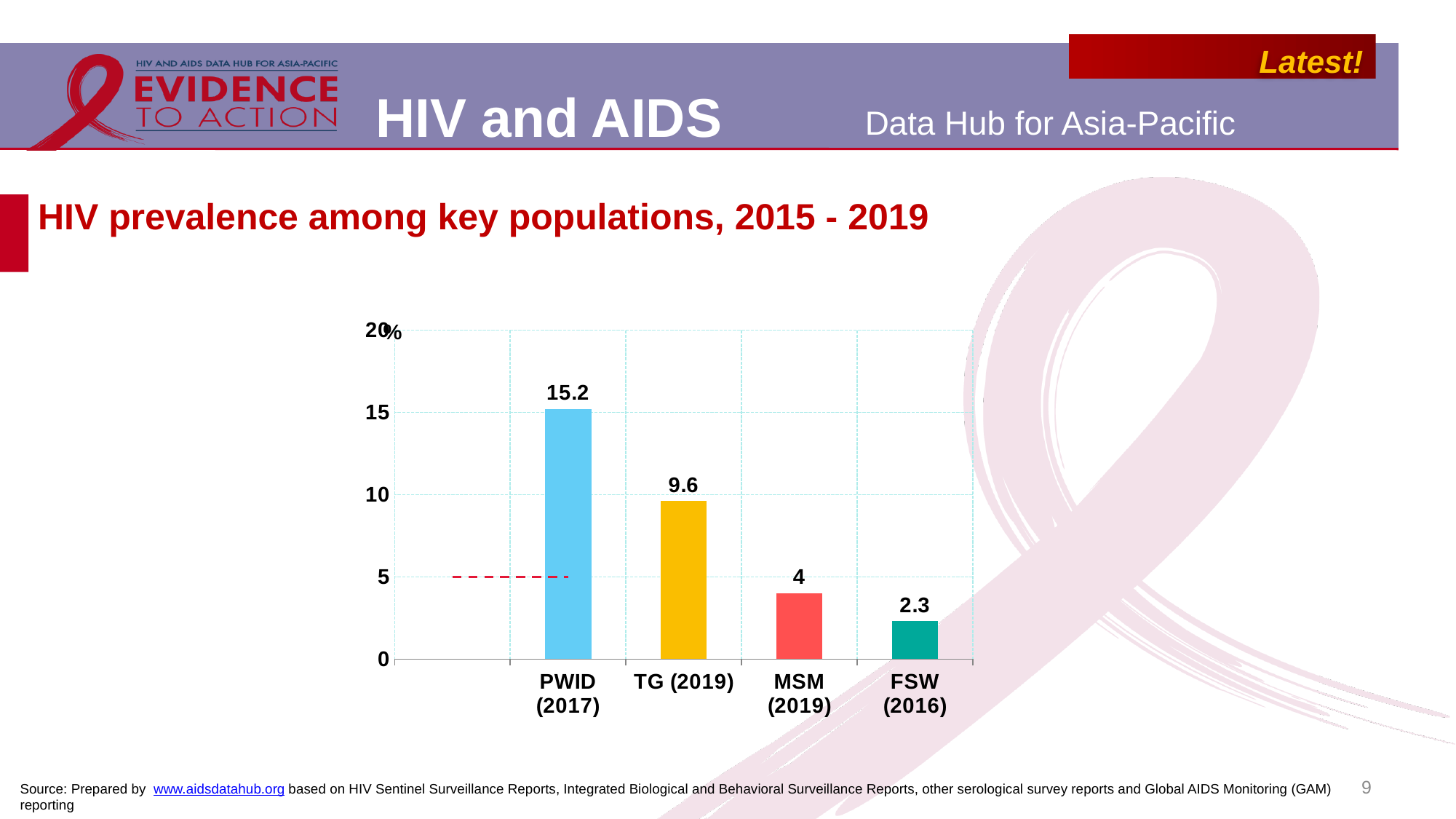
Which has a higher HIV prevalence, MSM (2019) or FSW (2016)? MSM (2019) Is the value for TG (2019) greater or less than 10? less Which key population has the lowest HIV prevalence on the chart? FSW (2016) What is the HIV prevalence value shown for PWID (2017)? 15.2 Which key population has the highest HIV prevalence on the chart? PWID (2017) What is the HIV prevalence value shown for TG (2019)? 9.6 What is the HIV prevalence value shown for MSM (2019)? 4 How many key populations are shown on the chart? 4 What is the difference between the HIV prevalence for PWID (2017) and TG (2019)? 5.6 What is the title of the chart on the slide? HIV prevalence among key populations, 2015 - 2019 What is the HIV prevalence value shown for FSW (2016)? 2.3 What kind of chart is shown on the slide? bar chart